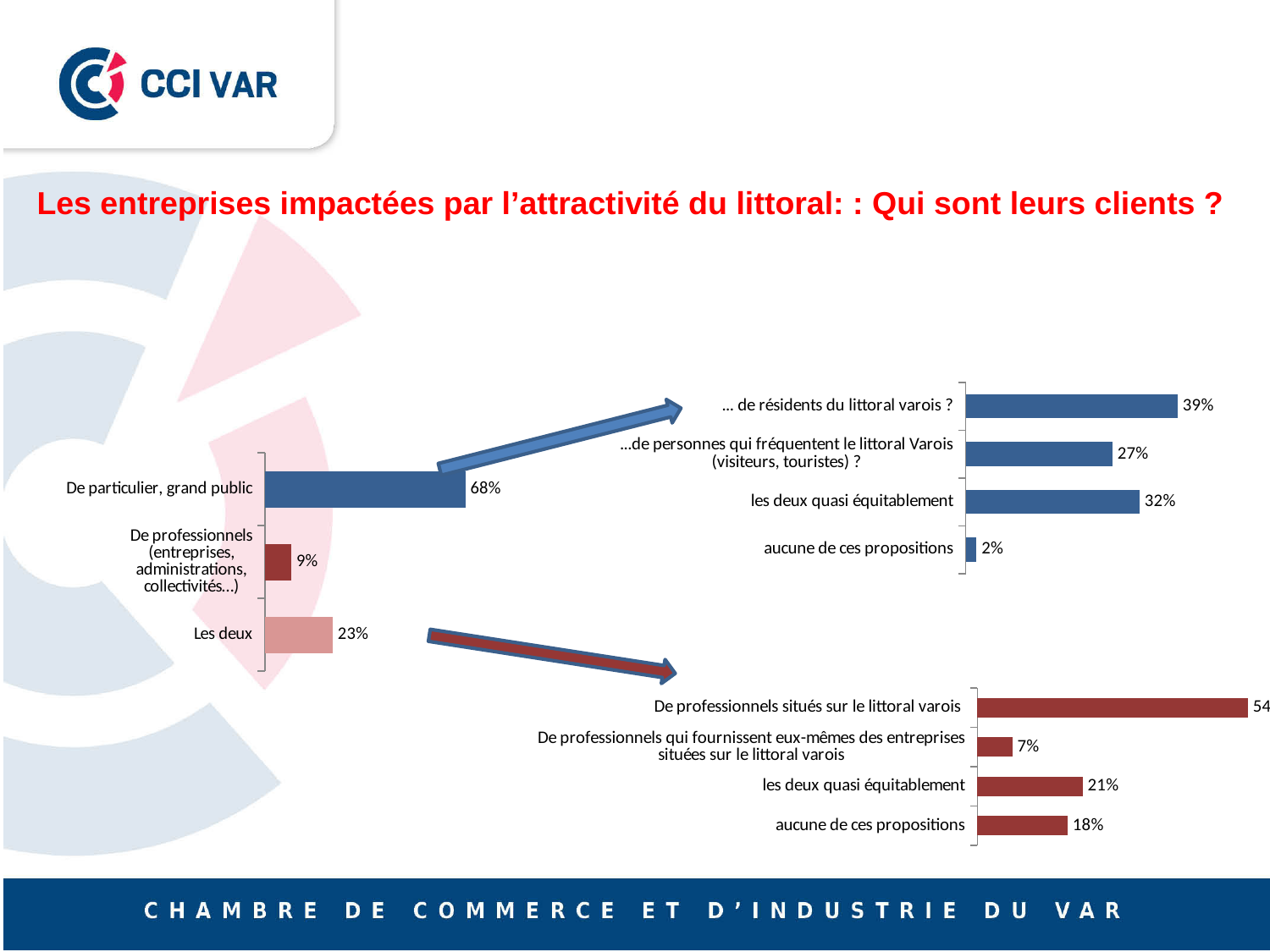
In the top-right chart, which is larger: '…de personnes qui fréquentent le littoral Varois (visiteurs, touristes) ?' or 'les deux quasi équitablement'? les deux quasi équitablement How many categories does the left chart show? 3 In the bottom-right chart, what is the value for 'les deux quasi équitablement'? 21% In the top-right chart, what is the difference between '… de résidents du littoral varois ?' and 'les deux quasi équitablement'? 7% In the top-right chart, what is the value for 'aucune de ces propositions'? 2% In the left chart, which category has the lowest value? De professionnels (entreprises, administrations, collectivités…) In the top-right chart, what is the value for '… de résidents du littoral varois ?'? 39% In the left chart, what is the difference between 'De particulier, grand public' and 'Les deux'? 45% What type of chart is the bottom-right chart? Bar chart In the left chart, what is the value for 'De particulier, grand public'? 68% In the bottom-right chart, which category has the highest value? De professionnels situés sur le littoral varois In the left chart, what is the value for 'Les deux'? 23%